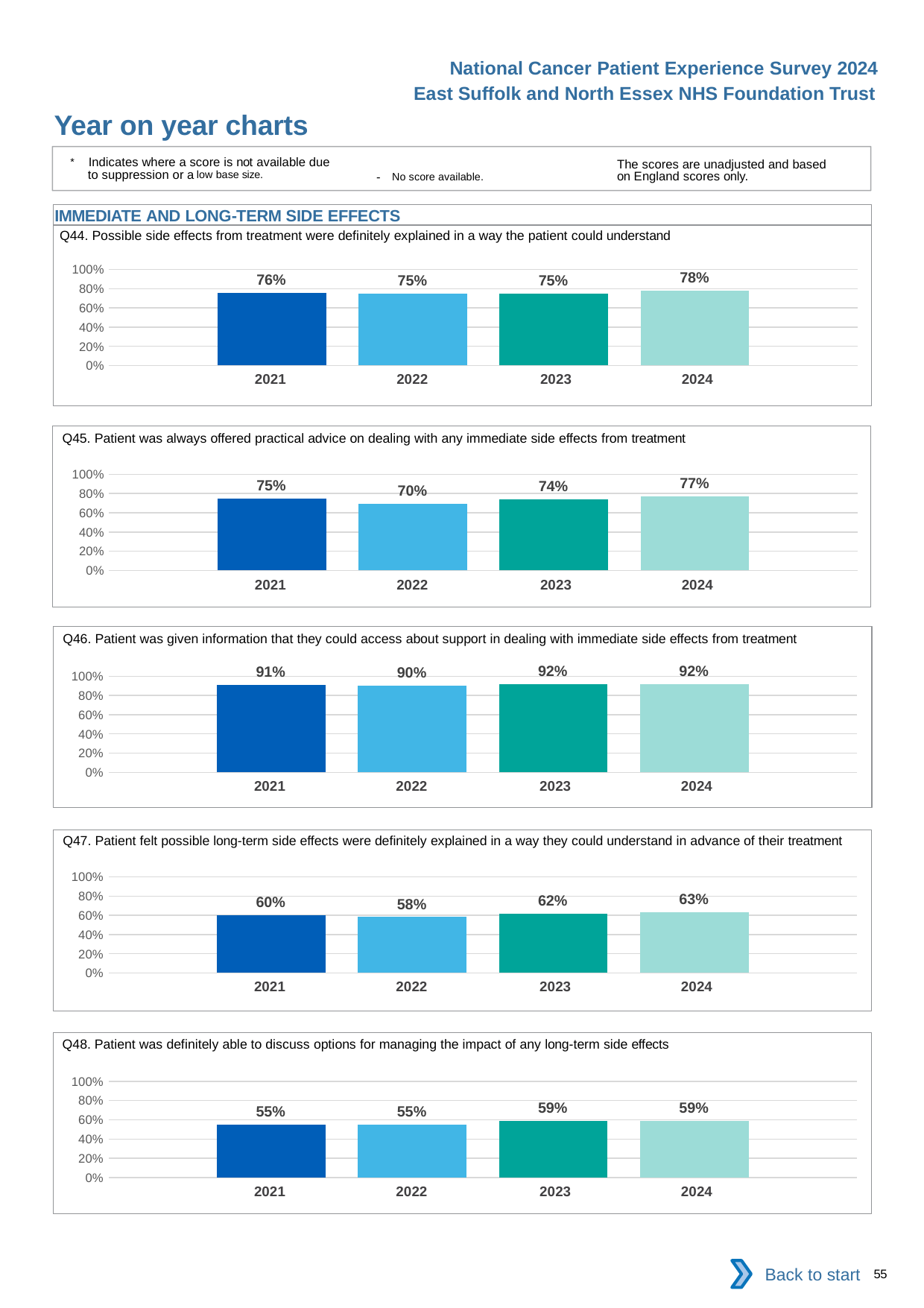
In the Q48 chart, what is the difference between the 2023 and 2021 values? 4 percentage points In the Q45 chart, what is the difference between the 2024 and 2022 values? 7 percentage points In the Q48 chart, is the value for 2024 greater or less than 40%? greater In the Q47 chart, which year has the highest value? 2024 How many charts are shown on the slide? 5 In the Q45 chart, which year has the lowest value? 2022 In the Q46 chart, what is the value for 2022? 90% In the Q48 chart, what is the value for 2021? 55% In the Q47 chart, is the value for 2021 larger or smaller than the value for 2022? larger How many years are shown in the Q44 chart? 4 In the Q44 chart, what is the value for 2024? 78% What kind of chart is the Q46 chart? bar chart